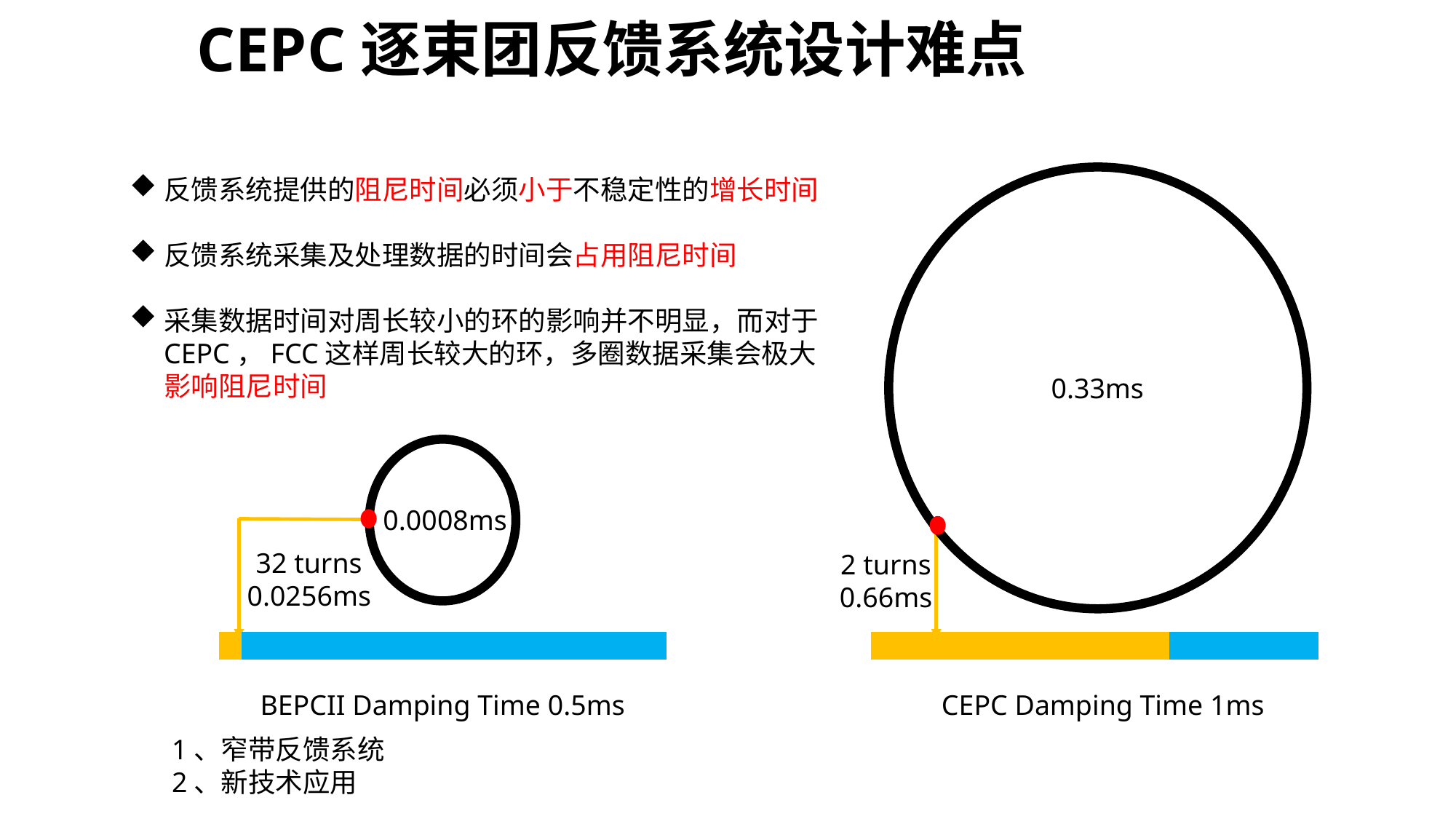
In the BEPCII diagram, how many turns are used for data acquisition? 32 turns In the CEPC diagram, how many turns are used for data acquisition? 2 turns What is the CEPC damping time stated under the right diagram? 1ms In the CEPC diagram, what is the revolution time printed inside the large ring? 0.33ms Which ring has the larger revolution time, BEPCII or CEPC? CEPC Which diagram shows the data acquisition time taking up a larger portion of the damping time bar, BEPCII or CEPC? CEPC In the CEPC diagram, how much time does the 2-turn data acquisition take? 0.66ms How many ring diagrams are shown on the slide? 2 In the BEPCII diagram, how much time does the 32-turn data acquisition take? 0.0256ms In the BEPCII diagram, what is the revolution time printed inside the small ring? 0.0008ms What is the BEPCII damping time stated under the left diagram? 0.5ms What colour is used for the data acquisition portion of the damping time bars? Yellow